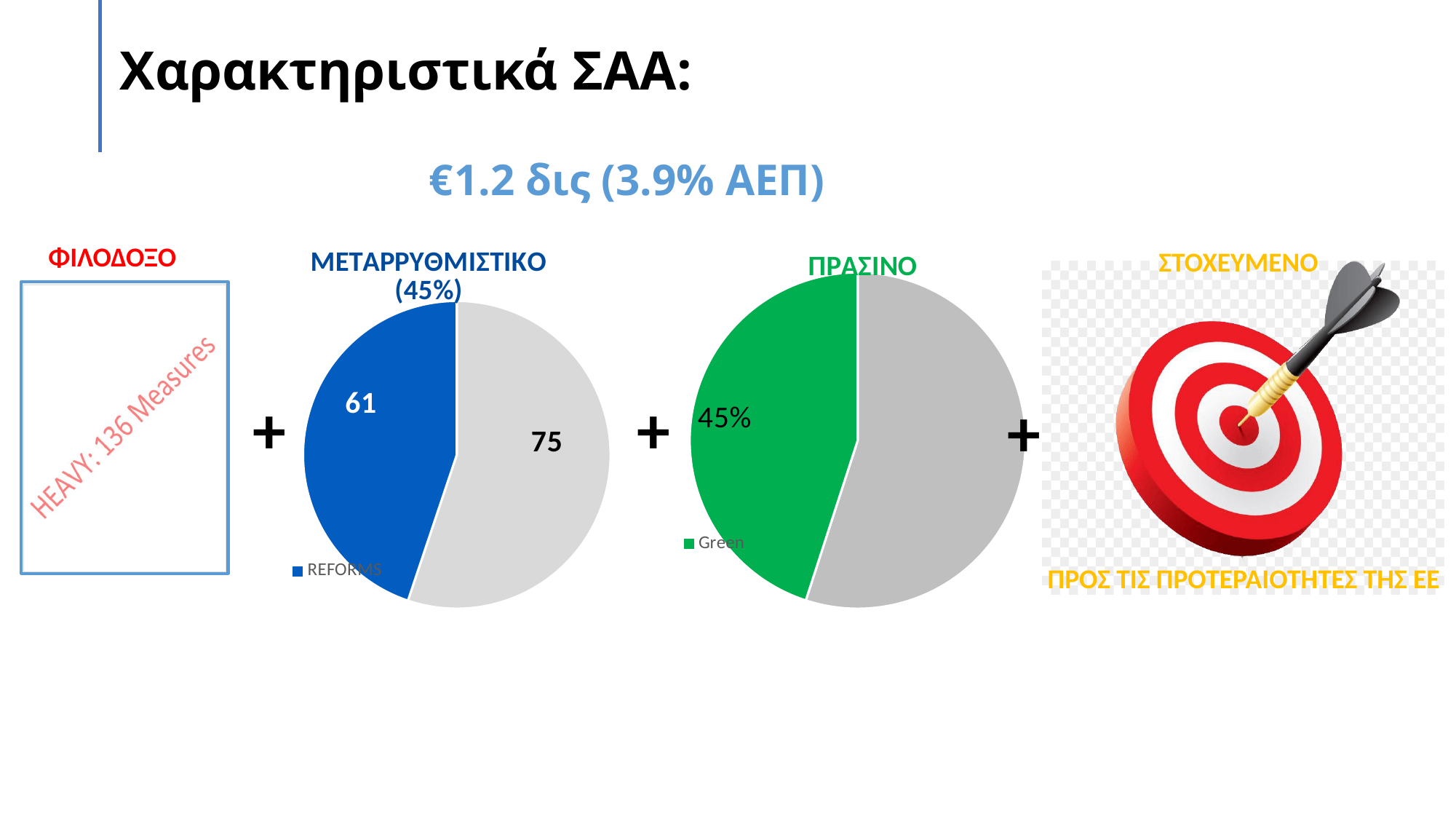
In the left pie chart (ΜΕΤΑΡΡΥΘΜΙΣΤΙΚΟ), what value is shown on the grey slice? 75 In the left pie chart (ΜΕΤΑΡΡΥΘΜΙΣΤΙΚΟ), what share of the pie does the REFORMS slice represent, as printed in the chart title? 45% What kind of chart is the right chart titled ΠΡΑΣΙΝΟ? pie chart What kind of chart is the left chart titled ΜΕΤΑΡΡΥΘΜΙΣΤΙΚΟ? pie chart In the left pie chart (ΜΕΤΑΡΡΥΘΜΙΣΤΙΚΟ), what is the difference between the grey slice value and the REFORMS slice value? 14 In the right pie chart (ΠΡΑΣΙΝΟ), which slice is larger, the green slice or the grey slice? the grey slice What is the legend entry shown for the right pie chart (ΠΡΑΣΙΝΟ)? Green In the left pie chart (ΜΕΤΑΡΡΥΘΜΙΣΤΙΚΟ), which slice is larger, the blue REFORMS slice or the grey slice? the grey slice In the left pie chart (ΜΕΤΑΡΡΥΘΜΙΣΤΙΚΟ), what value is shown on the blue REFORMS slice? 61 How many slices does the left pie chart (ΜΕΤΑΡΡΥΘΜΙΣΤΙΚΟ) have? 2 In the left pie chart (ΜΕΤΑΡΡΥΘΜΙΣΤΙΚΟ), what is the total of the two slice values? 136 In the right pie chart (ΠΡΑΣΙΝΟ), what percentage is shown on the green slice? 45%